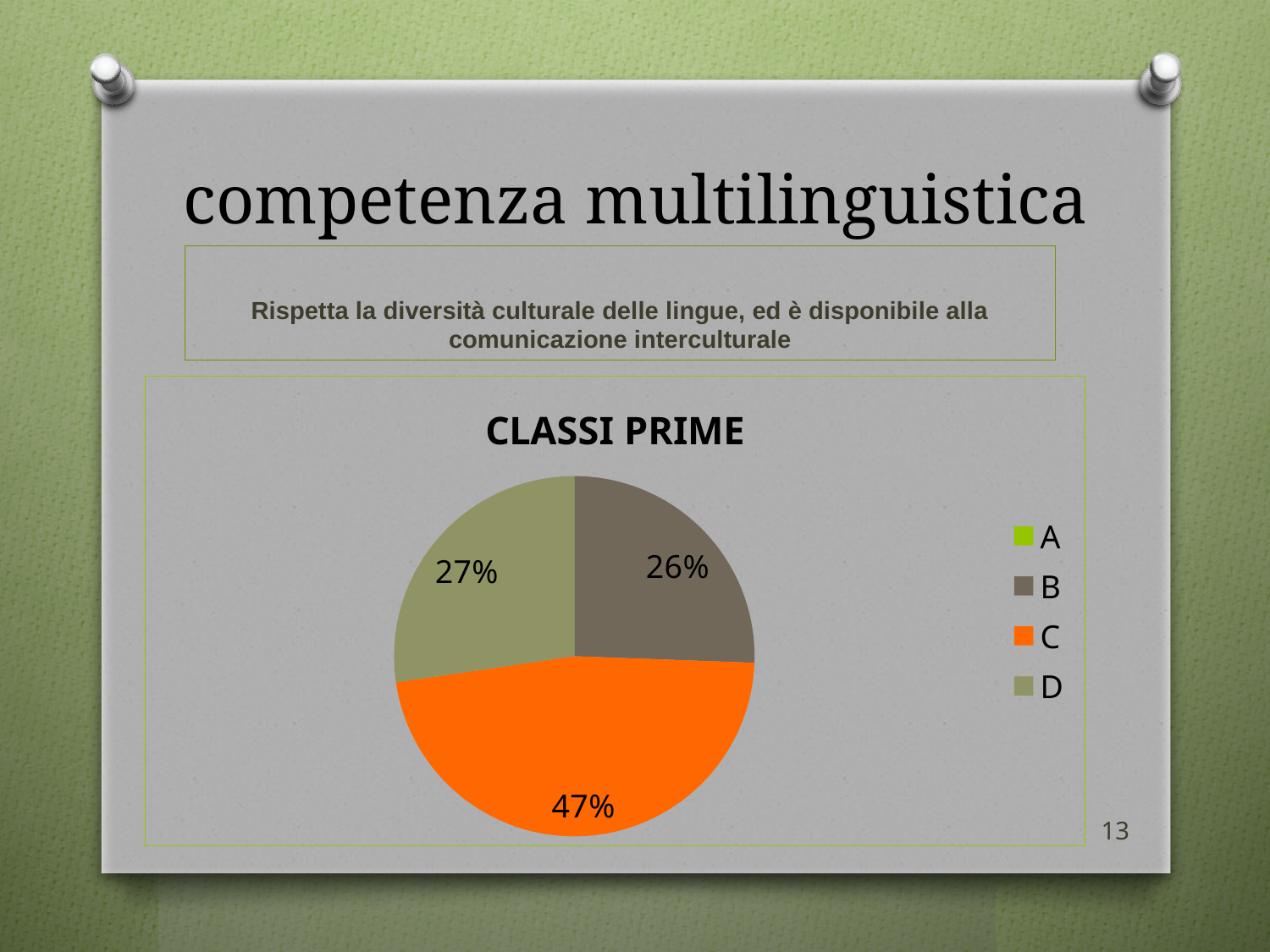
How many entries does the legend list? 4 What percentage of the pie does slice B represent? 26% What percentage of the pie does slice C represent? 47% What is the title of the chart? CLASSI PRIME Which is larger, the share for C or the share for D? C What is the difference in percentage points between slice C and slice B? 21 Which of the labelled slices has the smallest share of the pie? B Which slice has the largest share of the pie? C What percentage of the pie does slice D represent? 27% What kind of chart is shown on the slide? pie chart What colour is slice C in the pie chart? orange How many slices with percentage labels are visible in the pie? 3